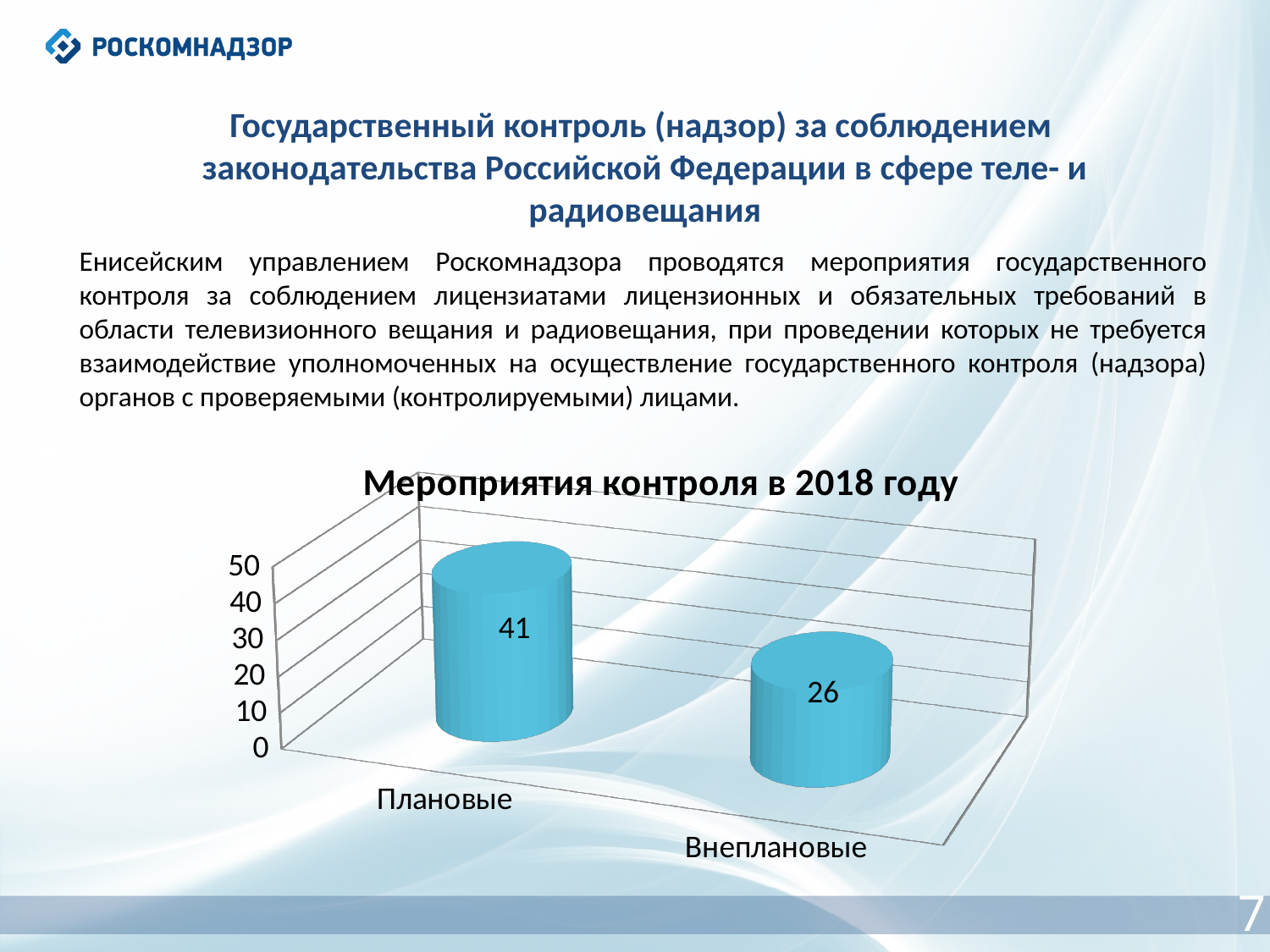
What is the maximum value shown on the vertical axis of the chart? 50 What kind of chart is shown on the slide? bar chart Which category has the lowest value? Внеплановые How many categories are shown in the chart? 2 Is the value for Плановые greater or less than 40? greater Which category has the highest value? Плановые What is the title of the chart? Мероприятия контроля в 2018 году Is the value for Внеплановые greater or less than 30? less What is the value for Плановые in the chart? 41 Which is larger, the value for Плановые or the value for Внеплановые? Плановые What is the difference between the values for Плановые and Внеплановые? 15 What is the value for Внеплановые in the chart? 26